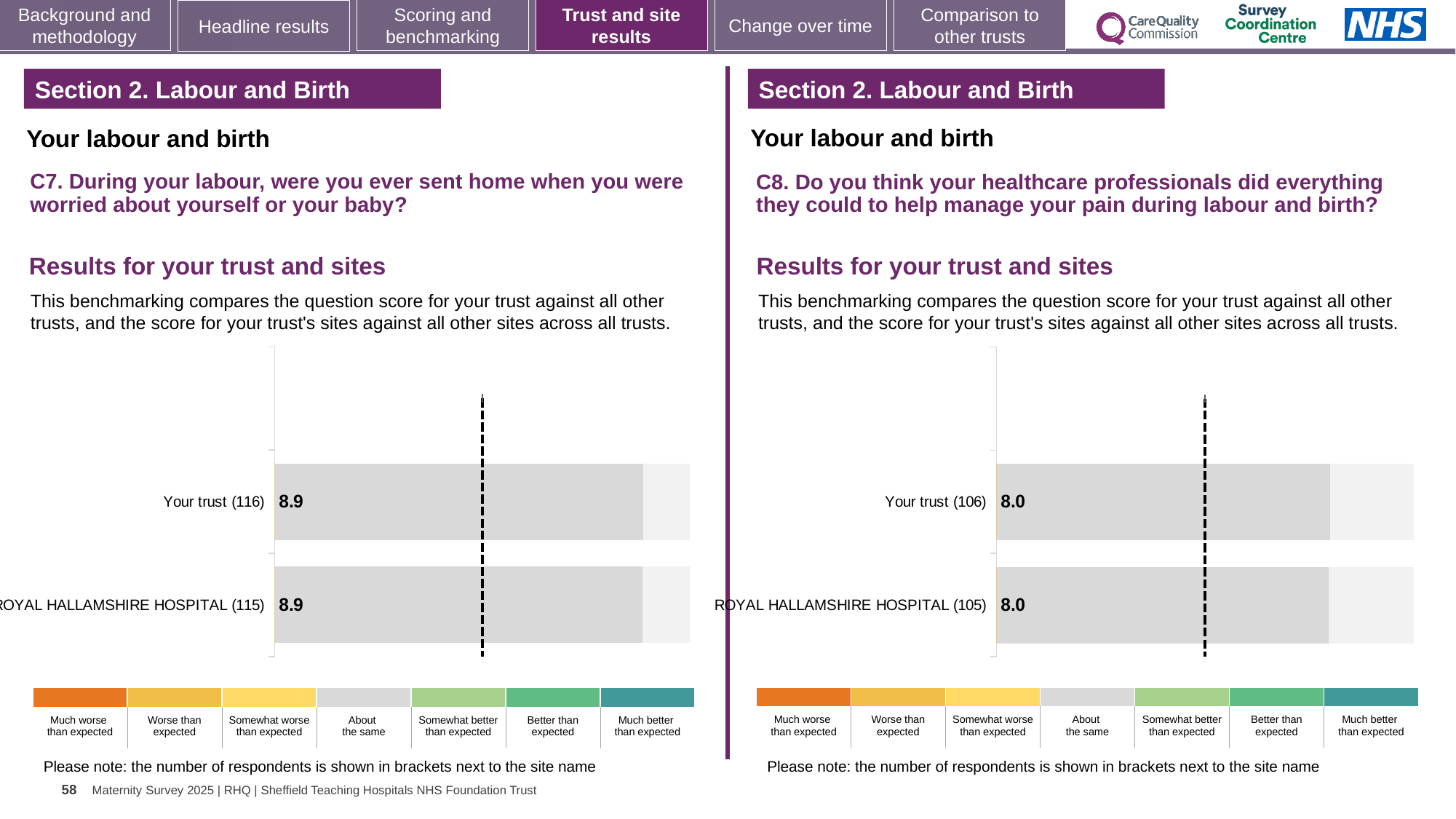
In the colour key below the right chart (C8), which category is shown in orange at the far left? Much worse than expected In the left chart (C7), what is the difference between the score for Your trust and the score for ROYAL HALLAMSHIRE HOSPITAL? 0.0 In the right chart (C8), what is the score for Your trust? 8.0 In the right chart (C8), what is the score for ROYAL HALLAMSHIRE HOSPITAL? 8.0 In the right chart (C8), how many bars are plotted? 2 In the left chart (C7), how many respondents are shown in brackets for Your trust? 116 In the left chart (C7), what is the score for ROYAL HALLAMSHIRE HOSPITAL? 8.9 What kind of chart is used on the left side of the slide for question C7? Bar chart In the right chart (C8), how many respondents are shown in brackets for ROYAL HALLAMSHIRE HOSPITAL? 105 How many benchmark categories does the colour key below the left chart (C7) list? 7 In the left chart (C7), how many bars are plotted? 2 In the left chart (C7), what is the score for Your trust? 8.9